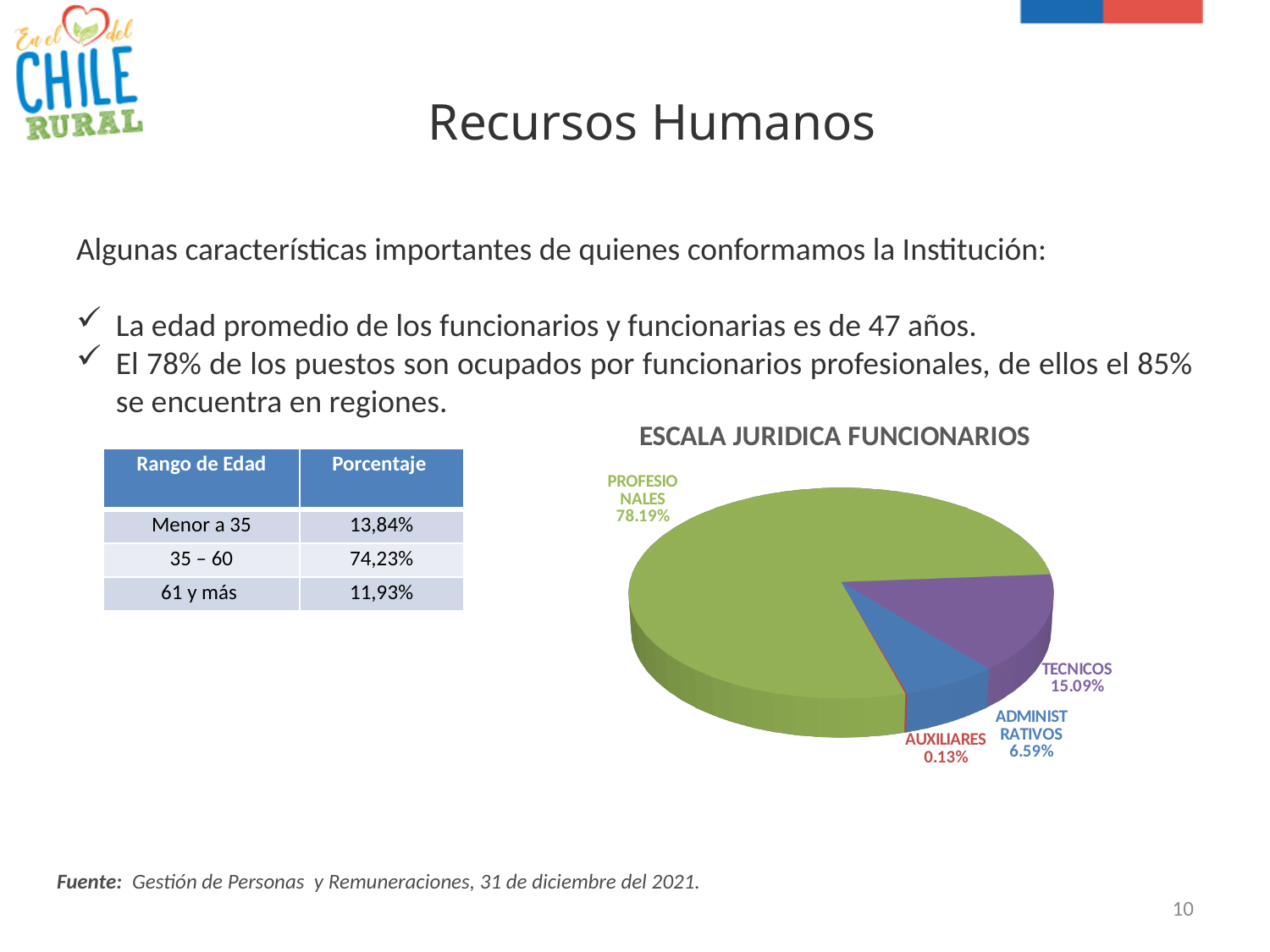
How many categories are shown in the pie chart? 4 What share of the pie chart is ADMINISTRATIVOS? 6.59% What is the title of the pie chart? ESCALA JURIDICA FUNCIONARIOS What is the difference between the TECNICOS and ADMINISTRATIVOS shares in the pie chart? 8.50% Which category has the smallest slice in the pie chart? AUXILIARES What colour is the PROFESIONALES slice in the pie chart? Green What share of the pie chart is PROFESIONALES? 78.19% What share of the pie chart is AUXILIARES? 0.13% What kind of chart is 'ESCALA JURIDICA FUNCIONARIOS'? Pie chart Which is larger in the pie chart, TECNICOS or ADMINISTRATIVOS? TECNICOS What share of the pie chart is TECNICOS? 15.09% Which category has the largest slice in the pie chart? PROFESIONALES